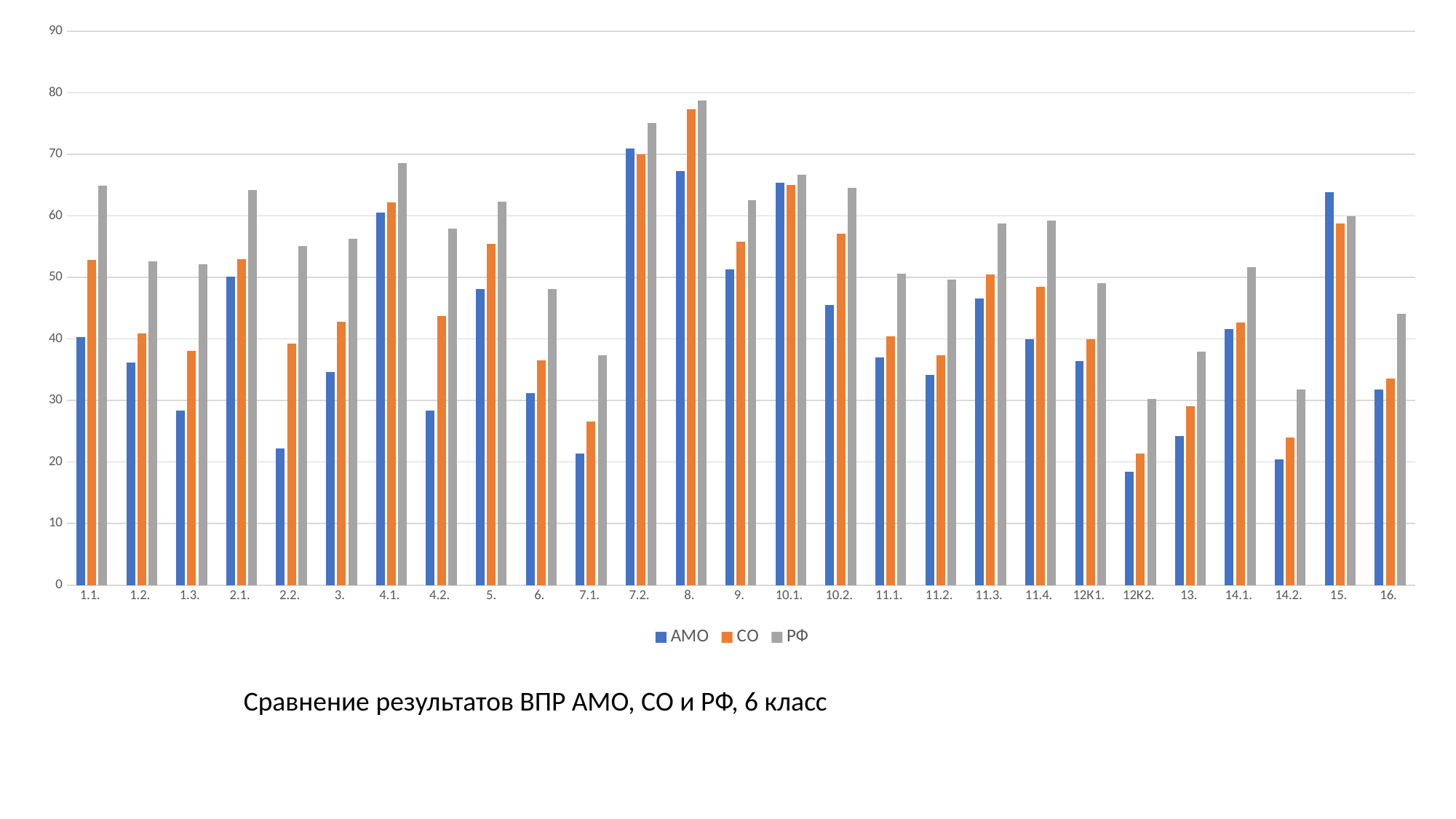
What kind of chart is shown on the slide? bar chart Is the value for АМО at category 12К2. greater or less than 20? less What is the title text shown below the chart? Сравнение результатов ВПР АМО, СО и РФ, 6 класс Is the value for РФ at category 1.1. greater or less than 60? greater Which category has the lowest value for the РФ series? 12К2. Is the value for СО at category 8. greater or less than 70? greater How many categories are shown on the x axis? 27 How many series does the legend list? 3 At category 15., which is larger: the АМО value or the СО value? АМО Which category has the highest value for the АМО series? 7.2. Which category has the lowest value for the АМО series? 12К2. Which category has the highest value for the РФ series? 8.